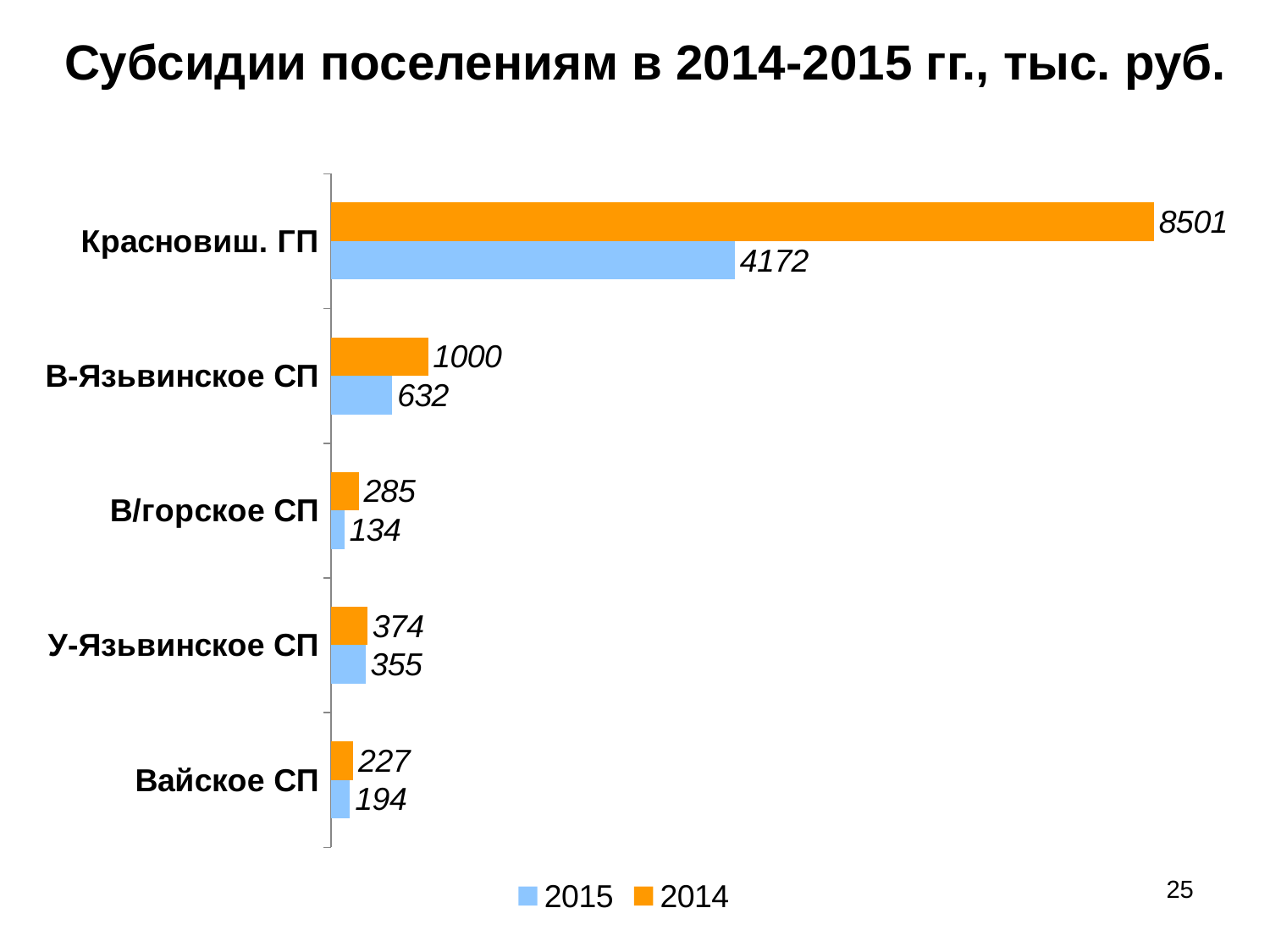
Which is larger for У-Язьвинское СП, the 2014 value or the 2015 value? 2014 Which category has the highest 2014 value? Красновиш. ГП How many categories are shown on the chart? 5 What is the difference between the 2014 and 2015 values for В/горское СП? 151 What kind of chart is shown on the slide? bar chart How many series does the legend list? 2 Which category has the lowest 2015 value? В/горское СП What is the difference between the 2014 and 2015 values for Красновиш. ГП? 4329 What is the 2014 value for Красновиш. ГП? 8501 What is the 2015 value for Вайское СП? 194 What is the 2015 value for В-Язьвинское СП? 632 Which colour represents the 2014 series? orange